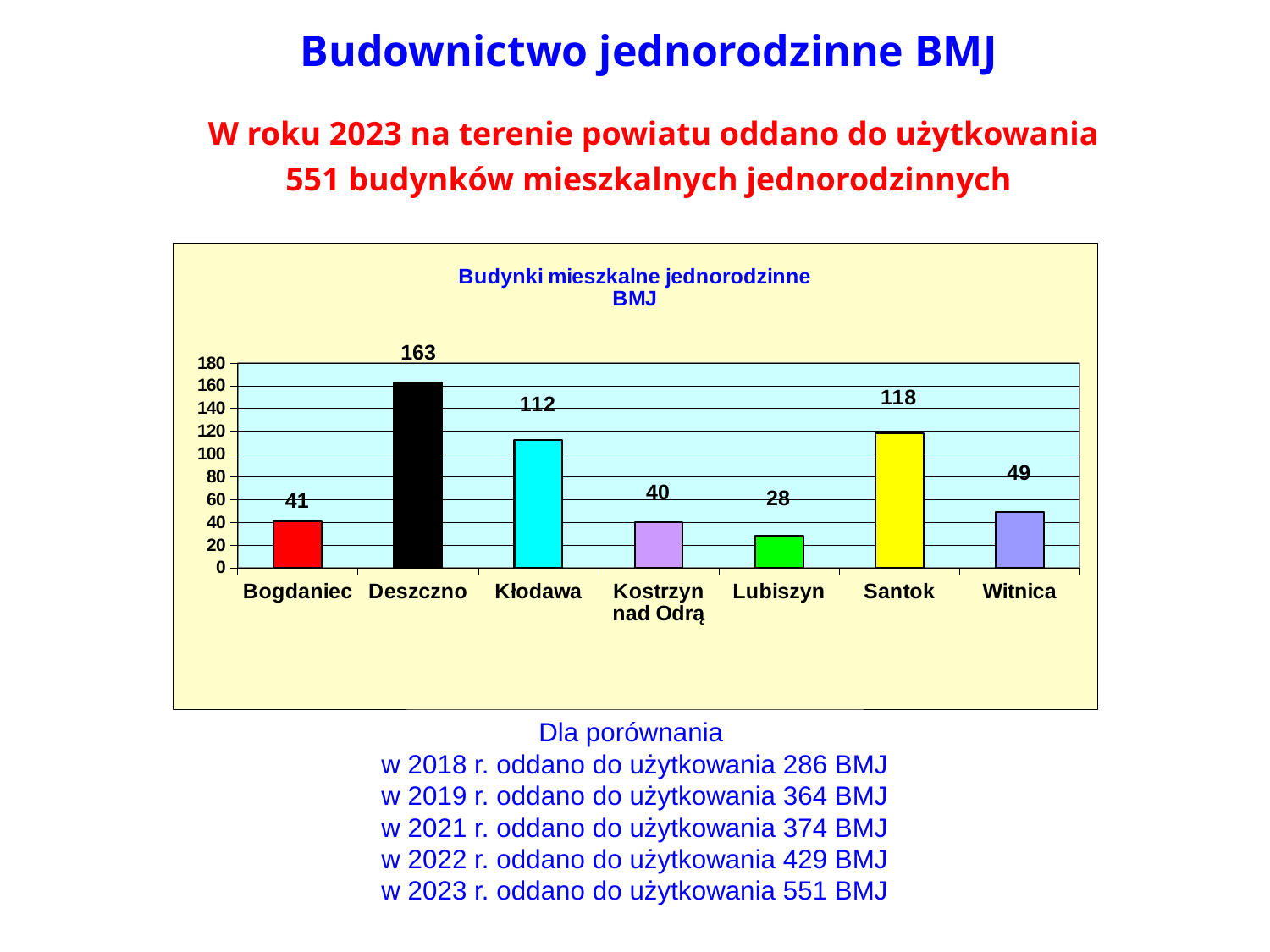
Which category has the lowest value? Lubiszyn What kind of chart is shown? bar chart What is the difference between the values for Deszczno and Santok? 45 What is the value for Kostrzyn nad Odrą? 40 Is the value for Bogdaniec greater or less than 60? less What is the title of the chart? Budynki mieszkalne jednorodzinne BMJ How many categories are shown on the x axis? 7 What is the value for Witnica? 49 What is the value for Deszczno? 163 Which is larger, the value for Kłodawa or the value for Santok? Santok Which category has the highest value? Deszczno What colour is the bar for Santok? yellow